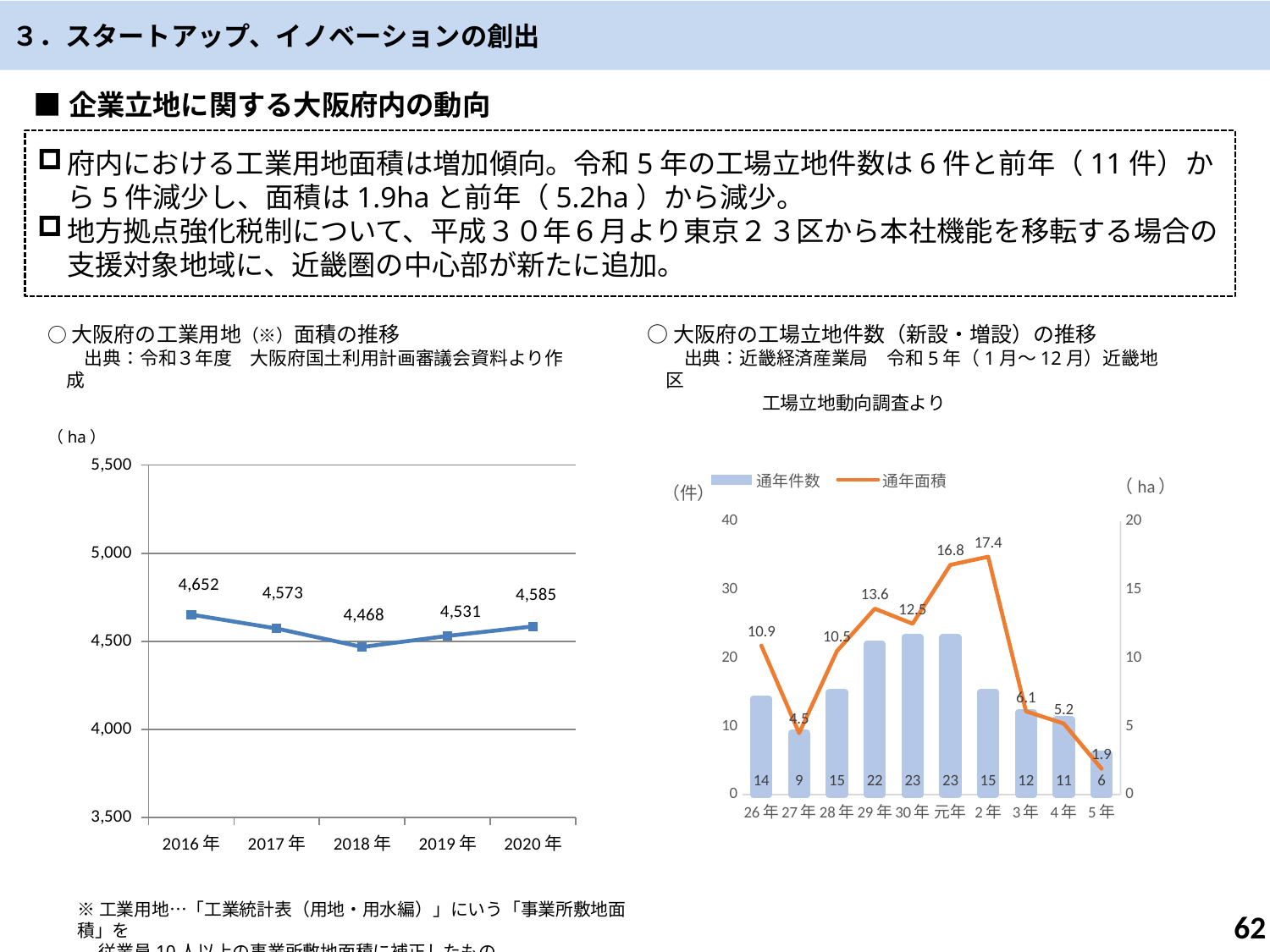
「大阪府の工業用地面積の推移」のグラフには何年分のデータ点がありますか。 5 「大阪府の工業用地面積の推移」のグラフは何種類のグラフですか。 折れ線グラフ 「大阪府の工場立地件数の推移」のグラフで、2年の通年面積はいくつですか。 17.4 「大阪府の工場立地件数の推移」のグラフで、凡例にはいくつの系列がありますか。 2 「大阪府の工業用地面積の推移」のグラフで、2018年の値はいくつですか。 4,468 「大阪府の工場立地件数の推移」のグラフで、4年と5年の通年件数の差はいくつですか。 5 「大阪府の工場立地件数の推移」のグラフで、通年面積が最も大きい年はどれですか。 2年 「大阪府の工場立地件数の推移」のグラフで、通年件数が最も少ない年はどれですか。 5年 「大阪府の工業用地面積の推移」のグラフで、最も値が高い年はどれですか。 2016年 「大阪府の工業用地面積の推移」のグラフで、最も値が低い年はどれですか。 2018年 「大阪府の工場立地件数の推移」のグラフで、30年の通年件数はいくつですか。 23 「大阪府の工業用地面積の推移」のグラフで、2020年と2019年の値の差はいくつですか。 54